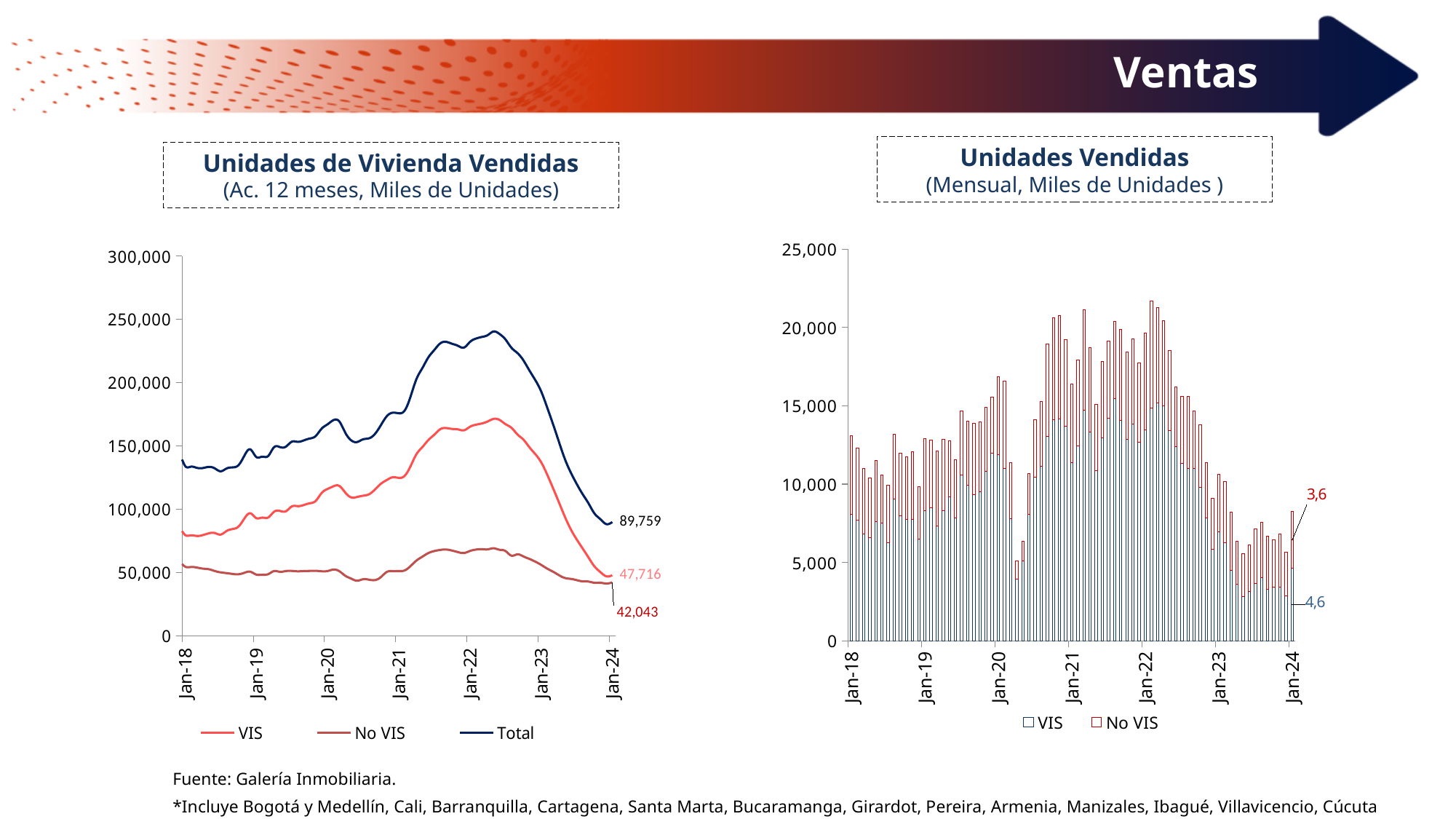
In the left chart, 'Unidades de Vivienda Vendidas', what is the value labelled for No VIS at Jan-24? 42,043 How many series does the legend of the left chart, 'Unidades de Vivienda Vendidas', list? 3 How many series does the legend of the right chart, 'Unidades Vendidas (Mensual)', list? 2 In the left chart, 'Unidades de Vivienda Vendidas', what is the difference between the VIS and No VIS values labelled at Jan-24? 5,673 In the right chart, 'Unidades Vendidas (Mensual)', what value is labelled for No VIS at the end of the series? 3,6 In the left chart, 'Unidades de Vivienda Vendidas', what is the value labelled for VIS at Jan-24? 47,716 In the left chart, 'Unidades de Vivienda Vendidas', does the Total line rise or fall between Jan-22 and Jan-24? fall What kind of chart is the left chart, 'Unidades de Vivienda Vendidas'? line chart In the left chart, 'Unidades de Vivienda Vendidas', is the Total value at Jan-22 greater or less than 200,000? greater In the left chart, 'Unidades de Vivienda Vendidas', what is the value labelled for Total at Jan-24? 89,759 In the left chart, 'Unidades de Vivienda Vendidas', which series has the highest value at Jan-24? Total What kind of chart is the right chart, 'Unidades Vendidas (Mensual)'? bar chart